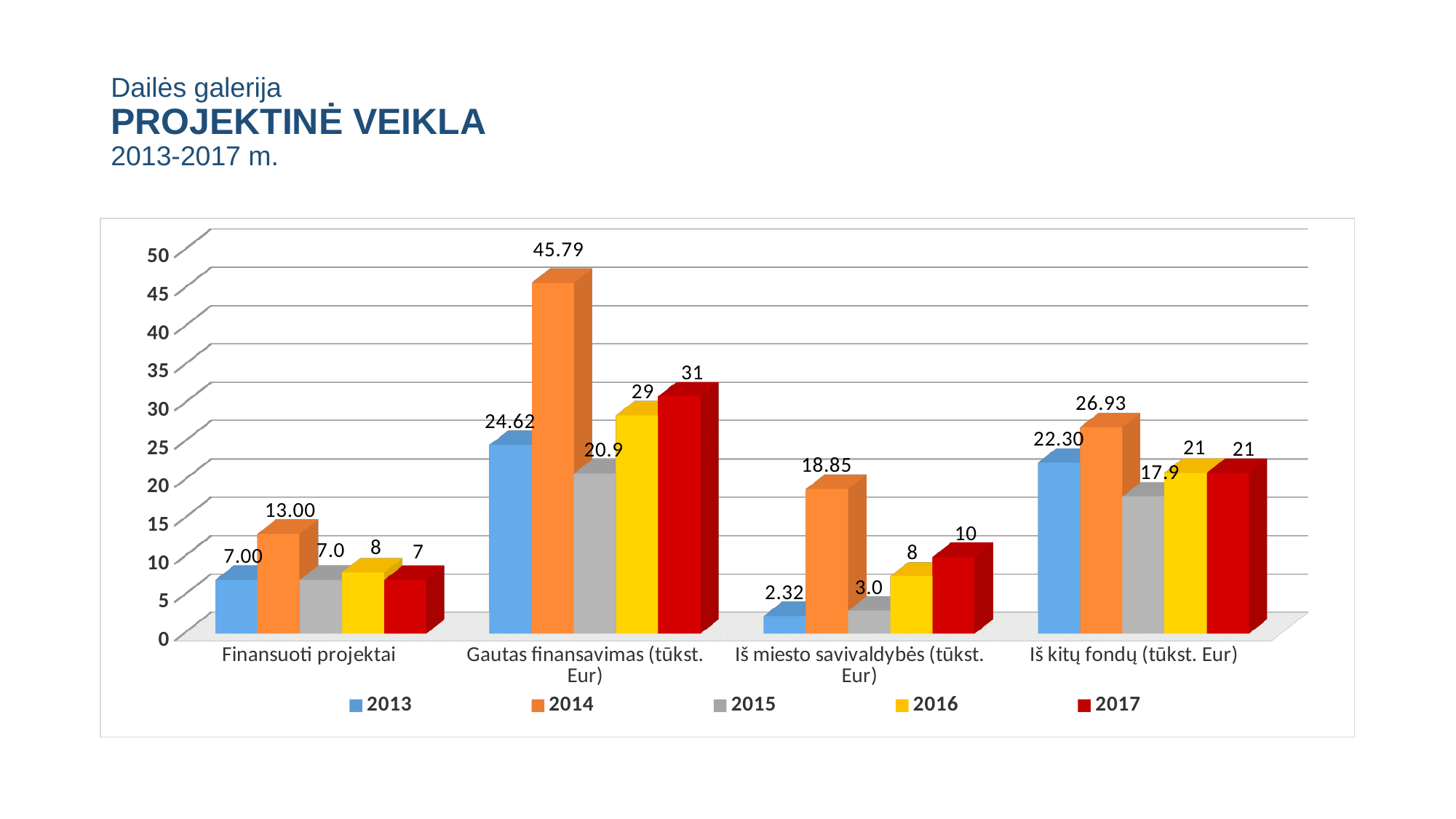
How many categories are shown on the x axis? 4 What is the value for 2013 in the Iš miesto savivaldybės (tūkst. Eur) category? 2.32 How many series does the legend list? 5 What kind of chart is shown on the slide? Bar chart What is the value for 2017 in the Finansuoti projektai category? 7 Which is larger in the Gautas finansavimas (tūkst. Eur) category: the 2016 value or the 2017 value? 2017 Which year has the lowest value in the Iš miesto savivaldybės (tūkst. Eur) category? 2013 What is the value for 2014 in the Gautas finansavimas (tūkst. Eur) category? 45.79 Which colour represents the 2016 series in the legend? Yellow What is the difference between the 2014 and 2013 values in the Iš kitų fondų (tūkst. Eur) category? 4.63 What is the value for 2015 in the Iš kitų fondų (tūkst. Eur) category? 17.9 Which year has the highest value in the Gautas finansavimas (tūkst. Eur) category? 2014